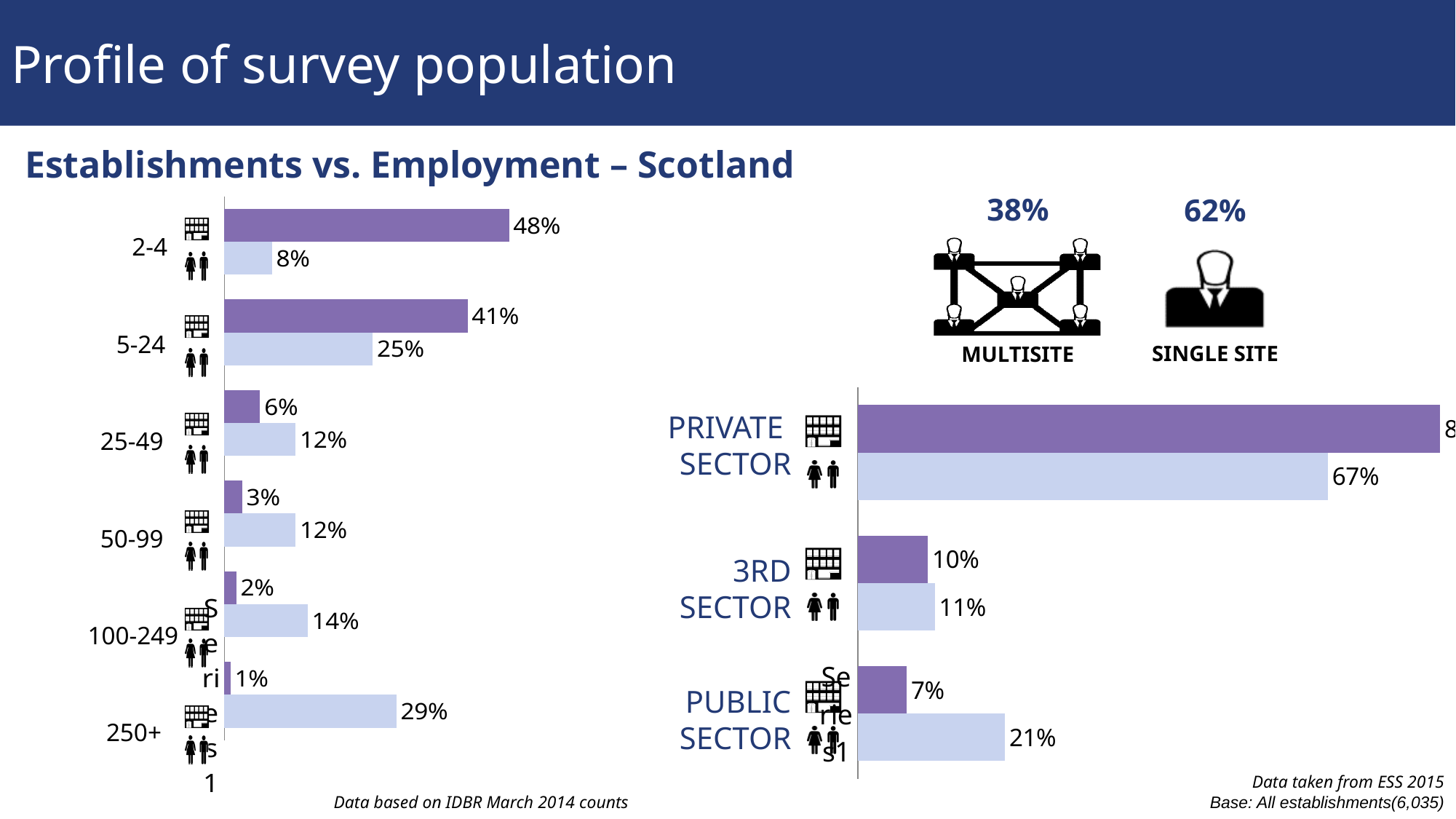
On the right chart (sectors), what is the difference between the light purple bar and the dark purple bar for the Public Sector? 14% On the left chart (size bands), what is the value of the light purple bar for the 250+ size band? 29% On the left chart (size bands), what is the difference between the dark purple bar and the light purple bar for the 2-4 size band? 40% On the left chart (size bands), what is the value of the dark purple bar for the 2-4 size band? 48% On the right chart (sectors), what is the value of the light purple bar for the Private Sector? 67% On the left chart (size bands), which size band has the highest dark purple bar? 2-4 On the left chart (size bands), do the dark purple bar values rise or fall as you move from the 2-4 band down to the 250+ band? fall On the right chart (sectors), what is the value of the dark purple bar for the Public Sector? 7% On the left chart (size bands), how many size bands are shown? 6 On the left chart (size bands), which size band has the lowest dark purple bar? 250+ On the left chart (size bands), what is the value of the light purple bar for the 5-24 size band? 25% What kind of chart is the right chart (sectors)? bar chart